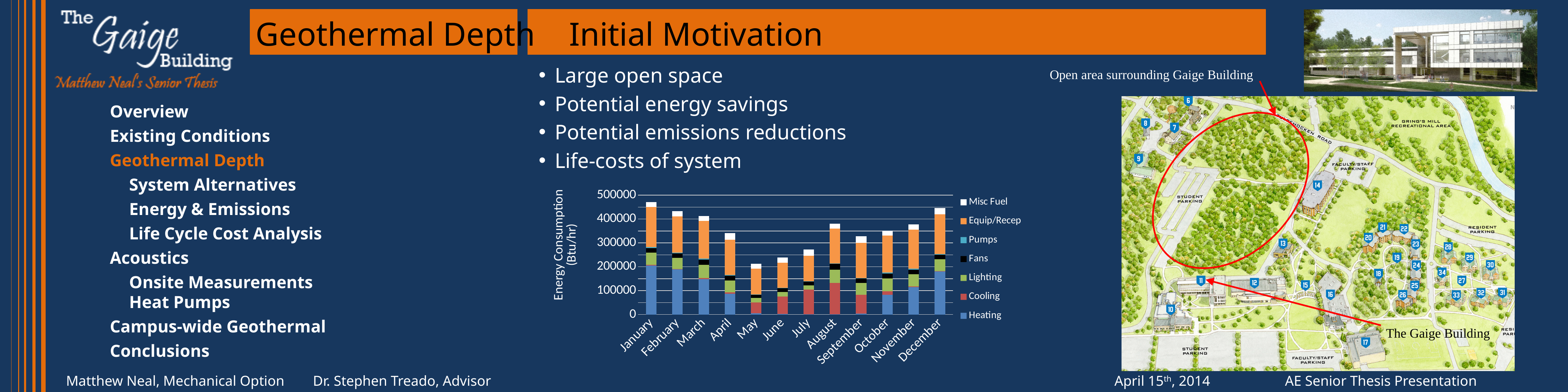
Is the total energy consumption for January greater or less than 400000? greater Do the total energy consumption values rise or fall from January to May? fall What kind of chart is shown on the slide? stacked bar chart Which month has the lowest total energy consumption in the chart? May Which month has a larger total energy consumption, January or May? January What is the label of the chart's y axis? Energy Consumption (Btu/hr) Is the total energy consumption for August greater or less than 400000? less Which month has the highest total energy consumption in the chart? January Is the total energy consumption for May greater or less than 300000? less Which series is plotted at the bottom of each stacked bar in the chart? Heating How many series does the chart's legend list? 7 How many months are shown along the x axis of the chart? 12